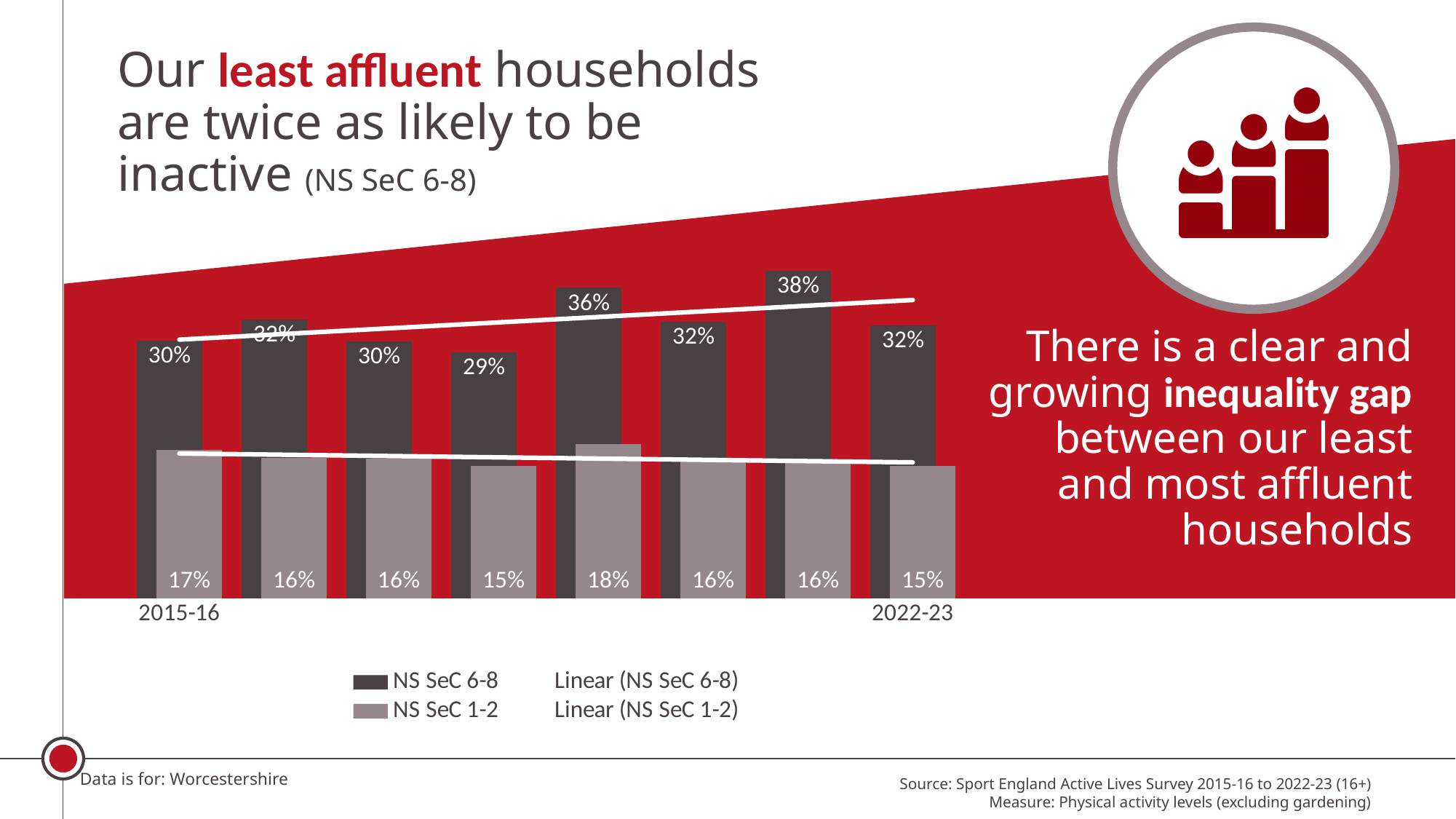
What is the difference between the NS SeC 6-8 and NS SeC 1-2 values in 2022-23? 17 percentage points How many time periods (pairs of bars) are plotted on the chart? 8 What is the highest value shown for the NS SeC 1-2 series? 18% What is the value for NS SeC 6-8 in 2022-23? 32% Which series has the larger value in 2022-23, NS SeC 6-8 or NS SeC 1-2? NS SeC 6-8 How many entries does the chart legend list? 4 What kind of chart is shown on the slide? Bar chart What is the value for NS SeC 6-8 in 2015-16? 30% What is the value for NS SeC 1-2 in 2022-23? 15% What is the lowest value shown for the NS SeC 6-8 series? 29% What is the difference between the NS SeC 6-8 and NS SeC 1-2 values in 2015-16? 13 percentage points What is the highest value shown for the NS SeC 6-8 series? 38%